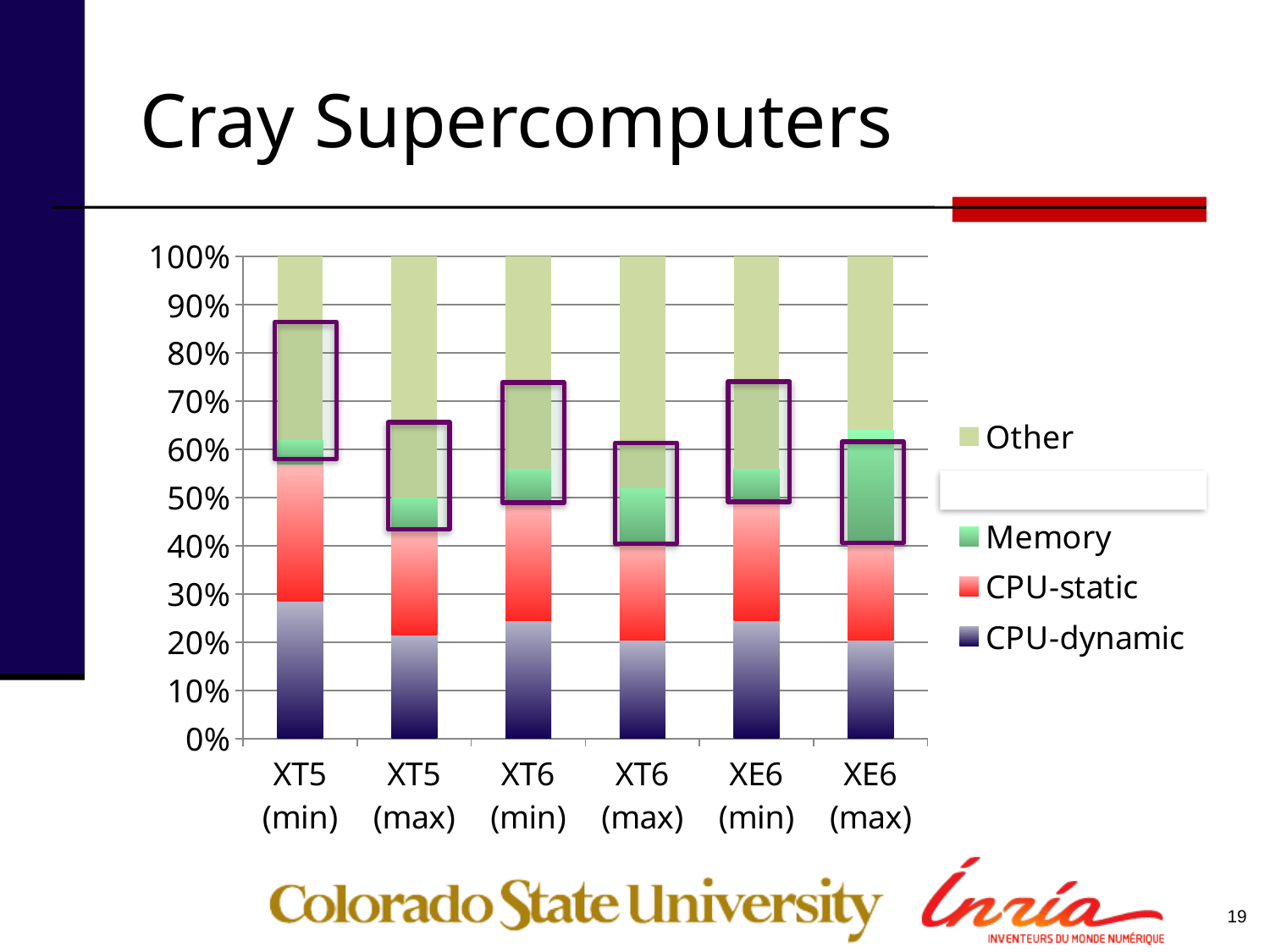
Which has the larger Memory segment, XE6 (max) or XT5 (min)? XE6 (max) What is the title of the slide containing the chart? Cray Supercomputers What kind of chart is shown on the slide? Stacked bar chart Is the CPU-dynamic value for XT6 (min) greater or less than 30%? less Which category has the smallest Memory segment? XT5 (min) Is the CPU-dynamic value for XT5 (min) greater or less than 20%? greater Is the Memory segment for XE6 (max) greater or less than 10% of the bar? greater How many categories (bars) are plotted along the x axis? 6 Which category has the largest CPU-dynamic segment? XT5 (min) Which series is shown at the bottom of each stacked bar? CPU-dynamic Which has the larger CPU-dynamic segment, XT5 (min) or XT5 (max)? XT5 (min) Which category has the largest Memory segment? XE6 (max)